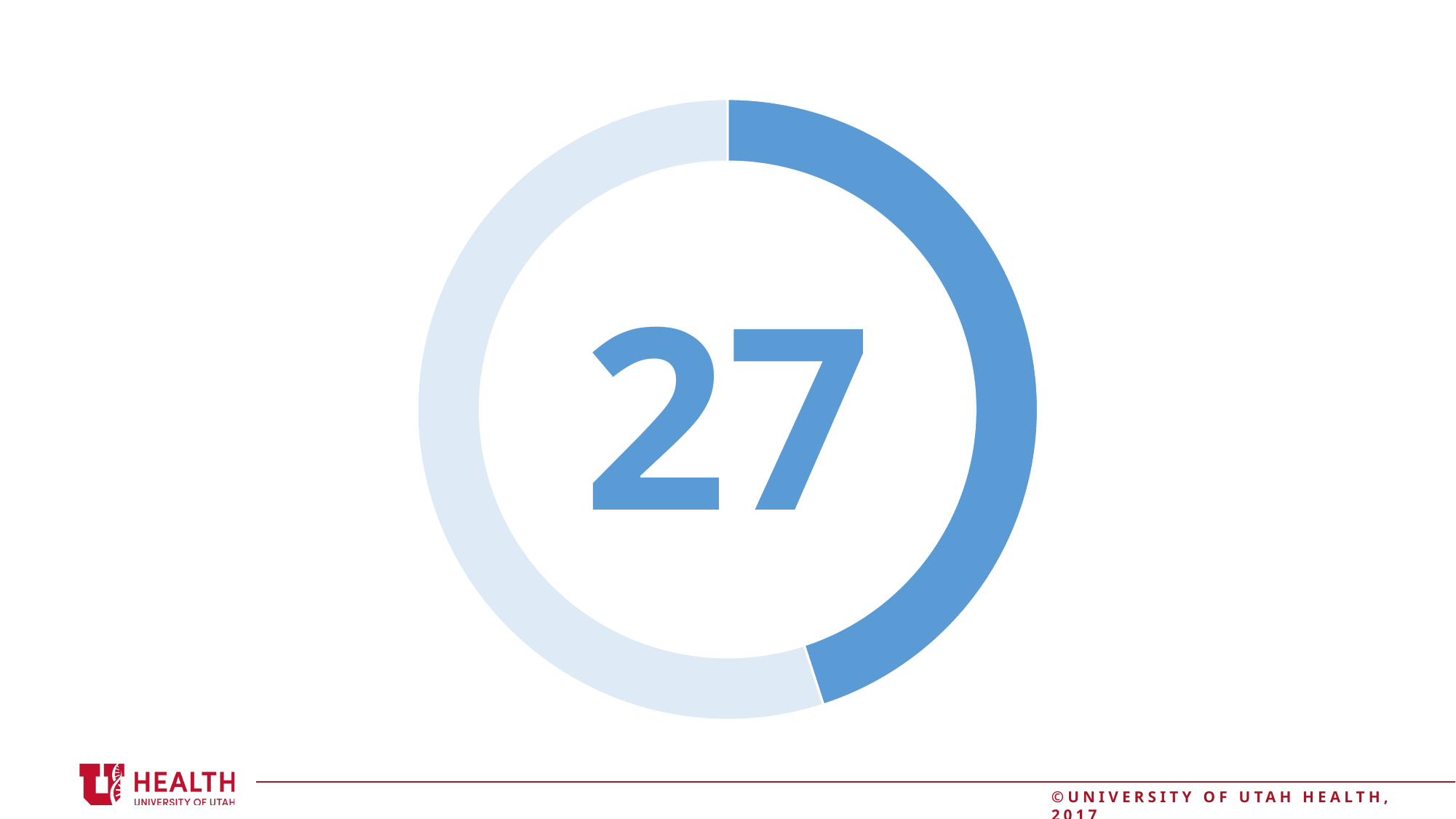
Does the doughnut chart display a legend? No Which segment of the doughnut chart is larger, the dark blue one or the light blue one? light blue What kind of chart is shown on the slide? doughnut chart What number is displayed in the center of the doughnut chart? 27 Does the dark blue segment cover more or less than half of the doughnut ring? less How many segments does the doughnut chart have? 2